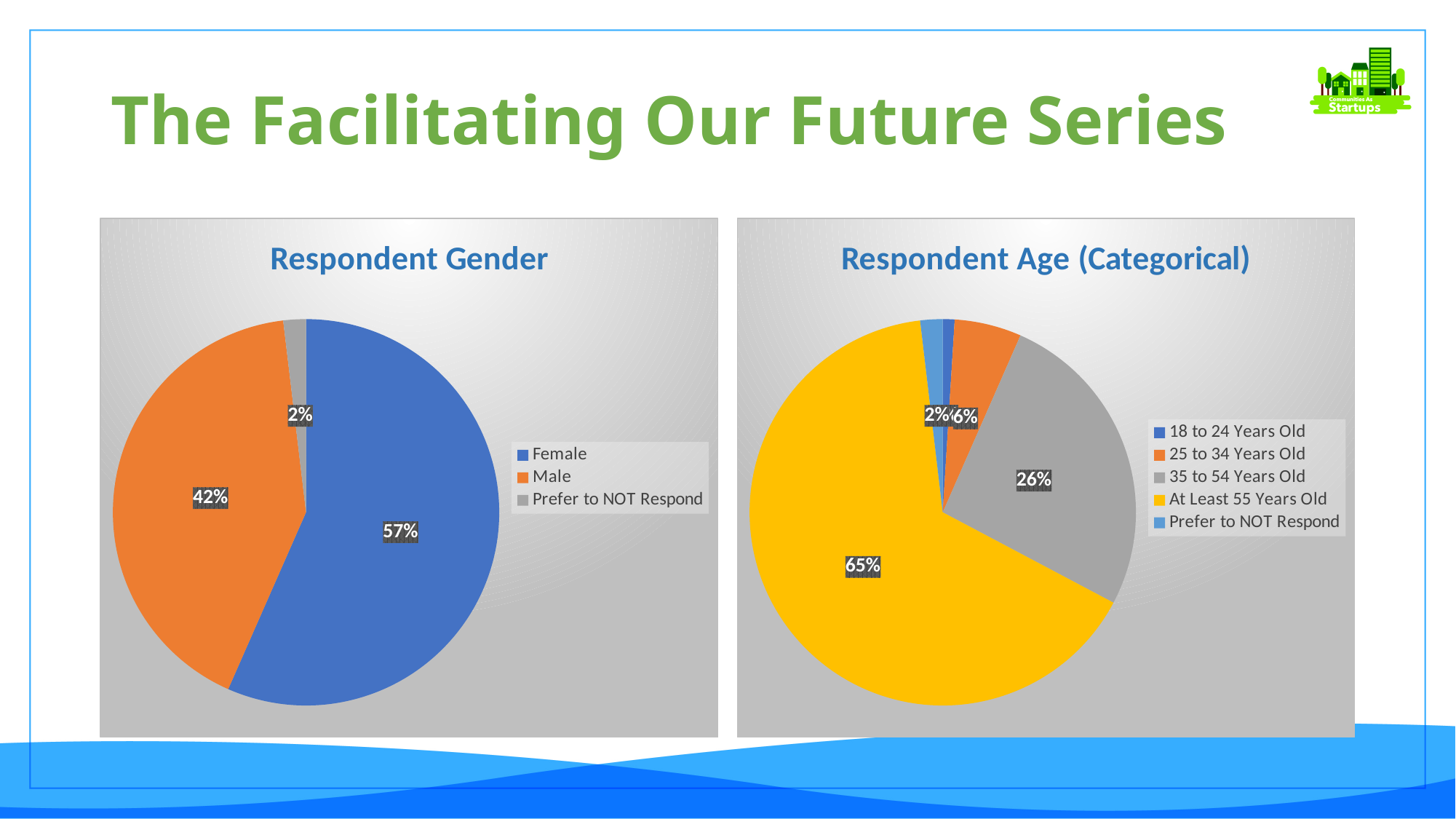
In the Respondent Gender chart, which category has the largest share? Female How many categories does the legend of the Respondent Age (Categorical) chart list? 5 In the Respondent Gender chart, what is the difference between the Female and Male shares? 15% In the Respondent Gender chart, what share of respondents are Female? 57% In the Respondent Gender chart, what share of respondents are Male? 42% In the Respondent Age (Categorical) chart, which is larger: the share for 35 to 54 Years Old or for 25 to 34 Years Old? 35 to 54 Years Old In the Respondent Age (Categorical) chart, what share of respondents are 35 to 54 Years Old? 26% In the Respondent Gender chart, what share of respondents chose Prefer to NOT Respond? 2% How many categories does the legend of the Respondent Gender chart list? 3 In the Respondent Age (Categorical) chart, which category has the largest share? At Least 55 Years Old What kind of chart is the Respondent Gender chart? pie chart In the Respondent Age (Categorical) chart, what share of respondents are At Least 55 Years Old? 65%